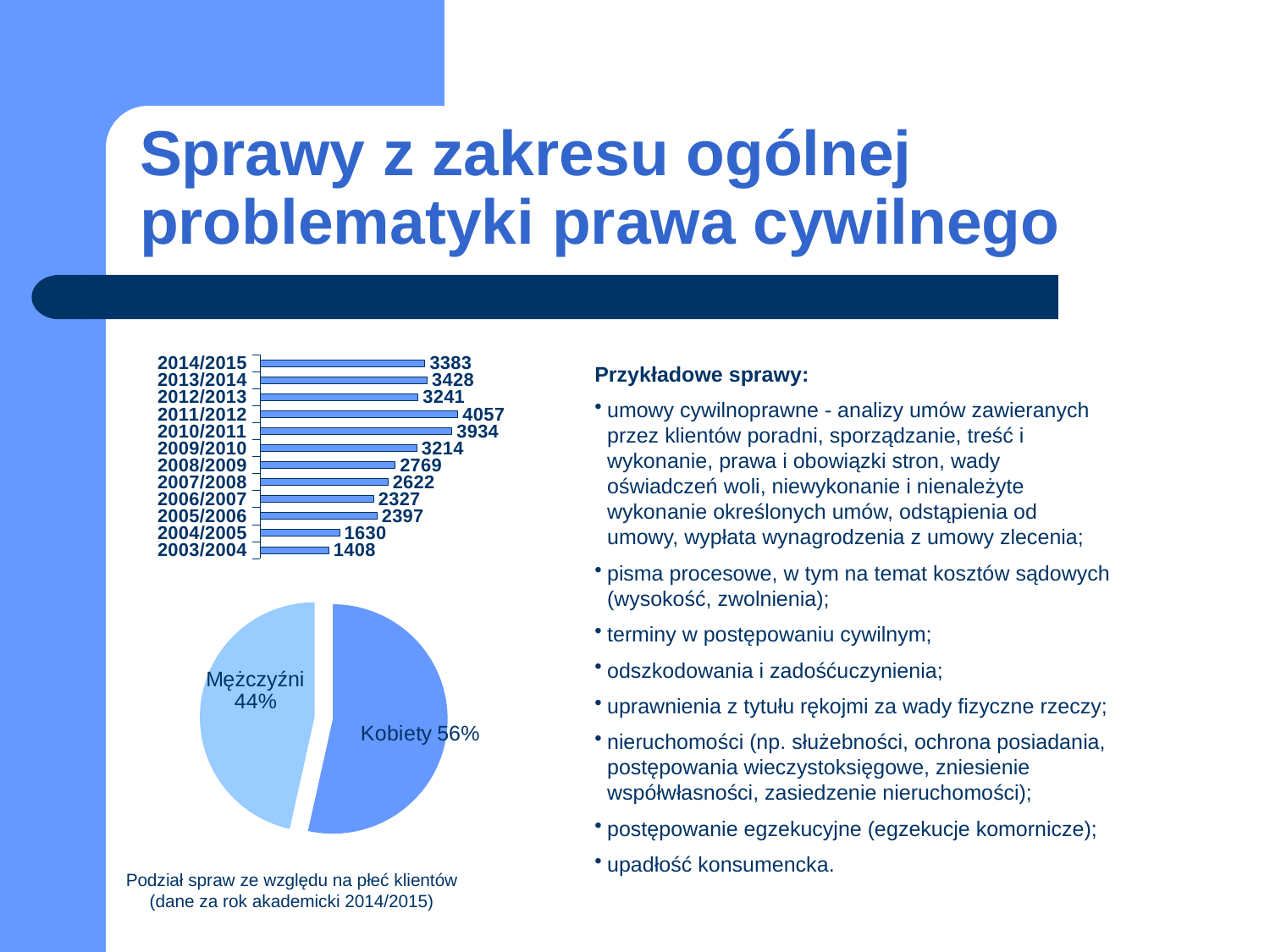
In the bar chart at the top left, what is the value for 2011/2012? 4057 In the pie chart titled 'Podział spraw ze względu na płeć klientów', which slice is larger: Kobiety or Mężczyźni? Kobiety In the bar chart at the top left, which is larger: the value for 2005/2006 or for 2006/2007? 2005/2006 What type of chart is shown at the top left of the slide? Bar chart In the bar chart at the top left, what is the value for 2014/2015? 3383 In the pie chart titled 'Podział spraw ze względu na płeć klientów', what share is Mężczyźni? 44% In the bar chart at the top left, which academic year has the lowest value? 2003/2004 In the bar chart at the top left, what is the value for 2003/2004? 1408 In the bar chart at the top left, which academic year has the highest value? 2011/2012 In the bar chart at the top left, how many academic years are shown? 12 In the bar chart at the top left, what is the difference between the values for 2011/2012 and 2003/2004? 2649 In the pie chart titled 'Podział spraw ze względu na płeć klientów', what share is Kobiety? 56%